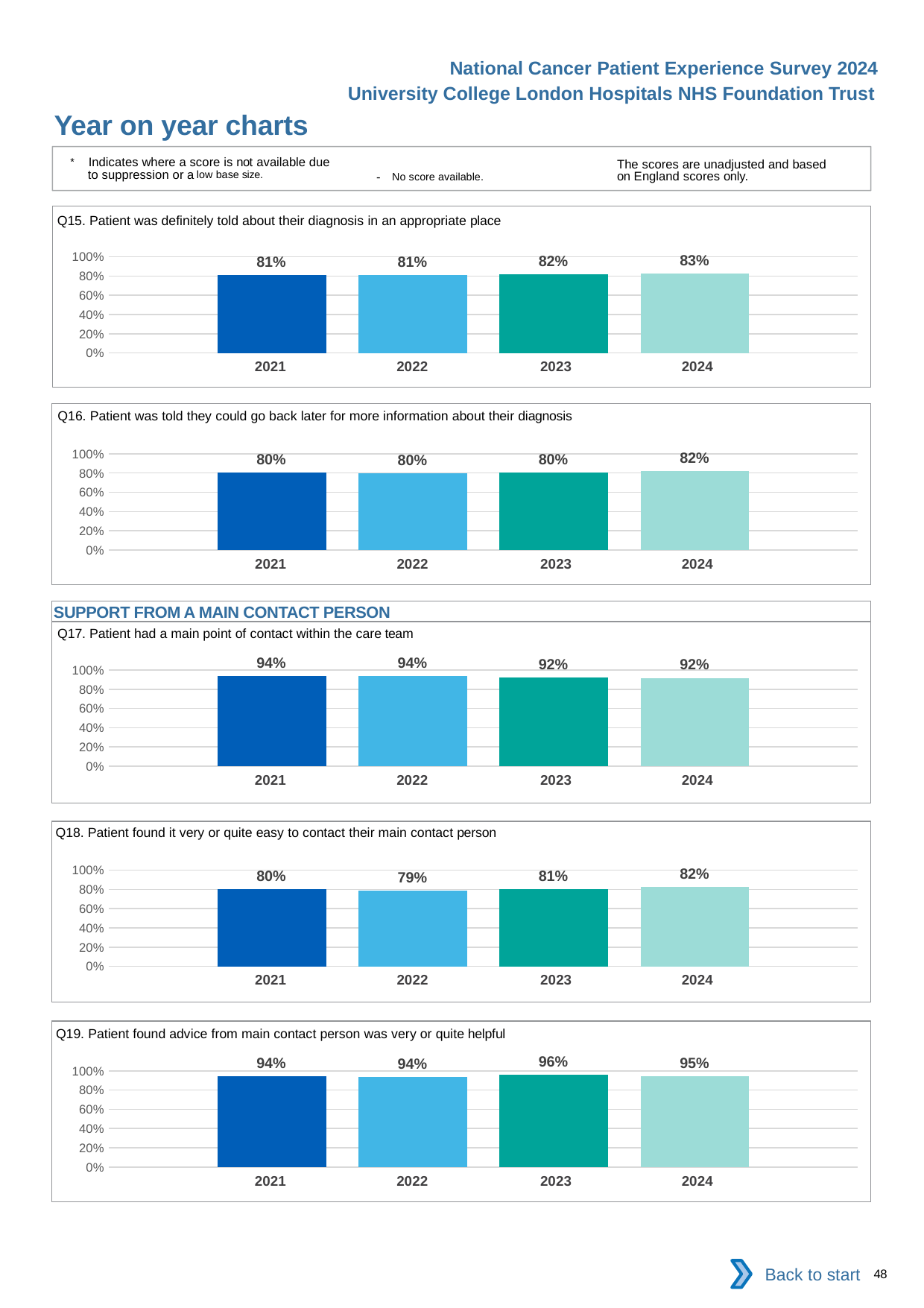
In the Q17 chart, do the values rise or fall from 2021 to 2024? Fall In the Q15 chart, how many years are shown on the x axis? 4 In the Q15 chart (Patient was definitely told about their diagnosis in an appropriate place), what is the value for 2024? 83% In the Q18 chart (Patient found it very or quite easy to contact their main contact person), which year has the highest value? 2024 In the Q16 chart (Patient was told they could go back later for more information about their diagnosis), what is the value for 2022? 80% In the Q17 chart (Patient had a main point of contact within the care team), which year has the lowest value? 2023 and 2024 (both 92%) In the Q19 chart, what is the value for 2024? 95% In the Q18 chart, which is larger, the value for 2022 or the value for 2023? 2023 What type of chart is used for Q16? Bar chart What is the section heading shown above the Q17 chart? SUPPORT FROM A MAIN CONTACT PERSON In the Q16 chart, what is the difference between the 2024 and 2023 values? 2 percentage points In the Q19 chart (Patient found advice from main contact person was very or quite helpful), what is the difference between the 2023 and 2021 values? 2 percentage points